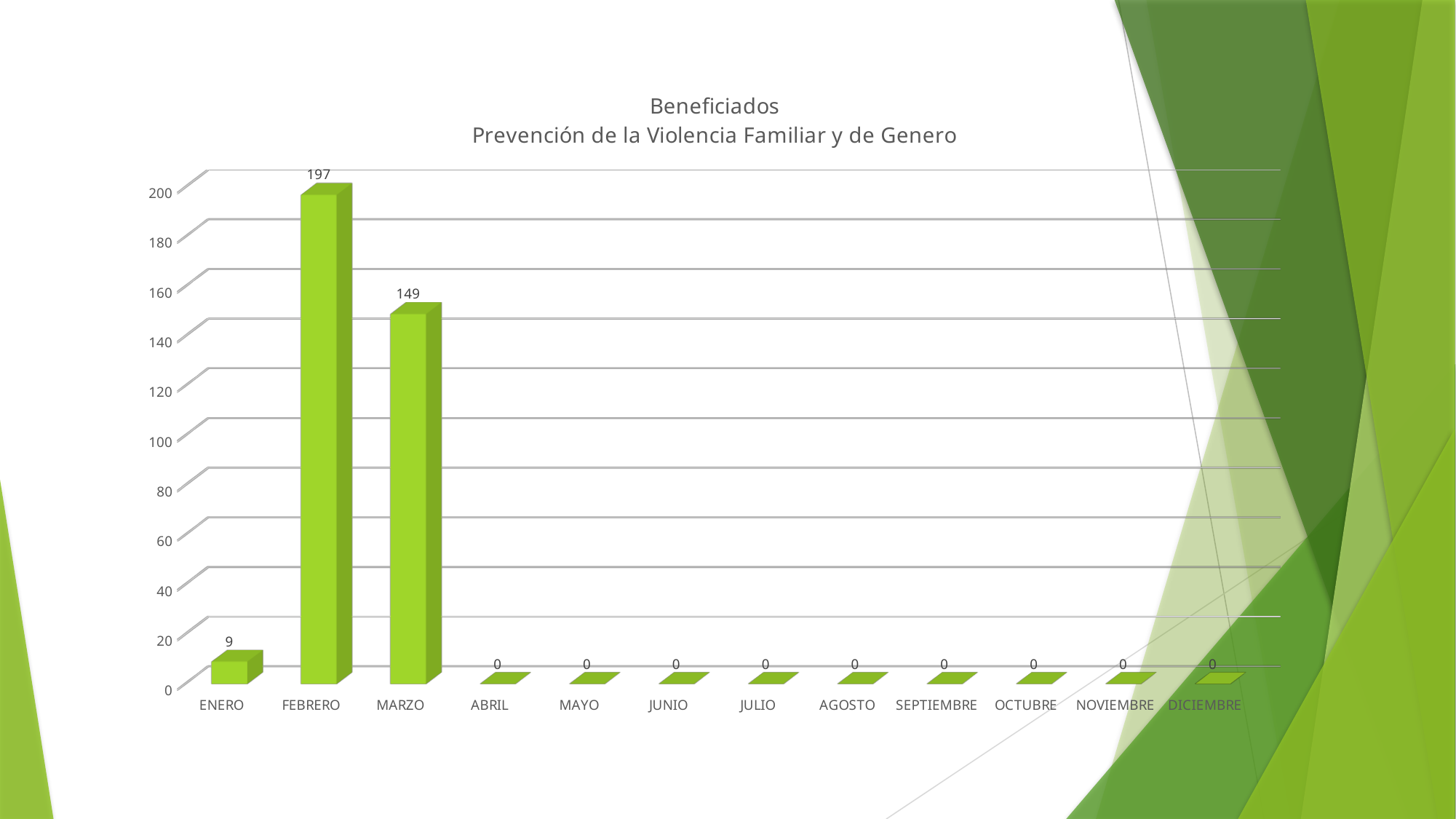
Which month has the highest value? FEBRERO What is the title of the chart? Beneficiados Prevención de la Violencia Familiar y de Genero What is the value for ABRIL? 0 What is the value for FEBRERO? 197 What is the difference between the values for MARZO and ENERO? 140 What is the value for ENERO? 9 Which is larger, the value for ENERO or the value for MARZO? MARZO How many months are shown on the x axis? 12 What is the difference between the values for FEBRERO and MARZO? 48 What is the value for MARZO? 149 Is the value for FEBRERO greater or less than 180? greater What kind of chart is this? bar chart